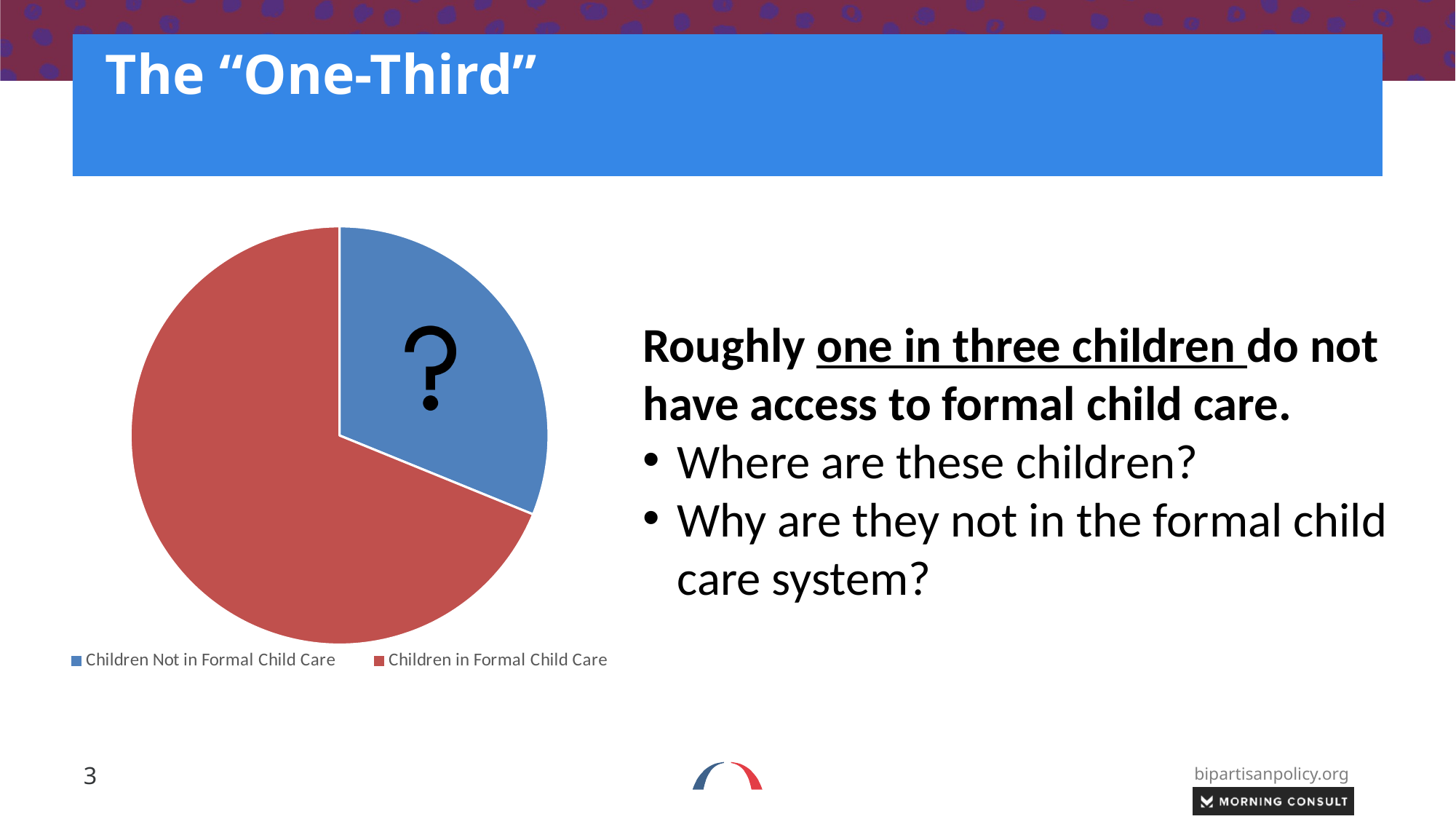
Which is larger in the pie chart: Children in Formal Child Care or Children Not in Formal Child Care? Children in Formal Child Care How many entries does the pie chart's legend list? 2 Which slice of the pie chart is the largest? Children in Formal Child Care Which legend entry is shown in red in the pie chart? Children in Formal Child Care What kind of chart is shown on the slide? Pie chart What colour is the Children Not in Formal Child Care slice in the pie chart? Blue How many slices does the pie chart have? 2 Which slice of the pie chart is the smallest? Children Not in Formal Child Care